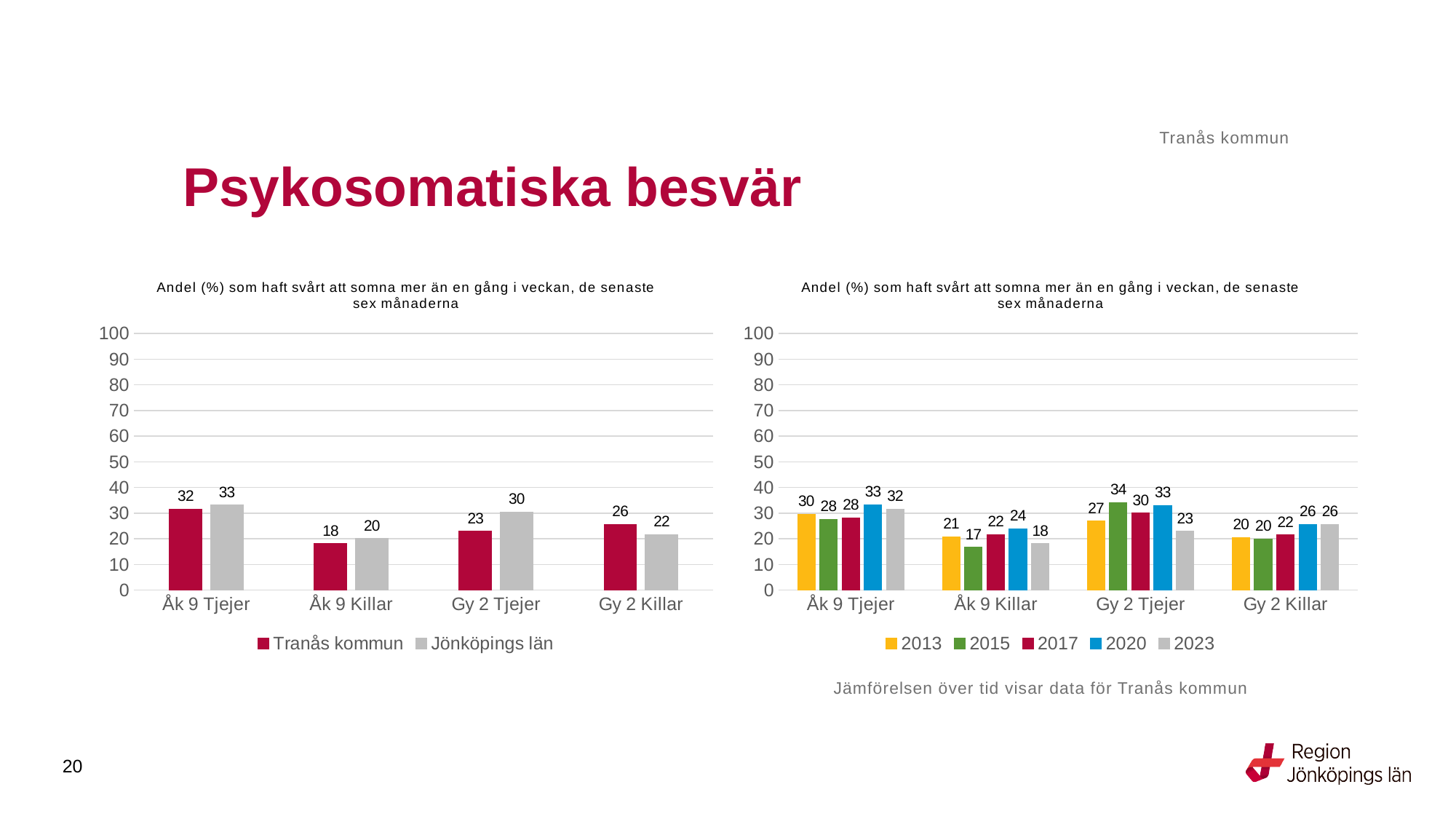
In the left chart, which is larger for Gy 2 Killar: Tranås kommun or Jönköpings län? Tranås kommun How many series does the legend of the right chart list? 5 In the left chart, what is the difference between Jönköpings län and Tranås kommun for Gy 2 Tjejer? 7 In the right chart, what is the value for 2023 for Åk 9 Killar? 18 What kind of chart is the right chart? Bar chart In the left chart, what is the value for Jönköpings län for Gy 2 Tjejer? 30 In the right chart, which year has the lowest value for Åk 9 Killar? 2015 How many series does the legend of the left chart list? 2 In the right chart, what is the difference between 2020 and 2013 for Gy 2 Killar? 6 In the right chart, what is the value for 2015 for Gy 2 Tjejer? 34 In the left chart, which category has the lowest value for Tranås kommun? Åk 9 Killar In the left chart, what is the value for Tranås kommun for Åk 9 Tjejer? 32